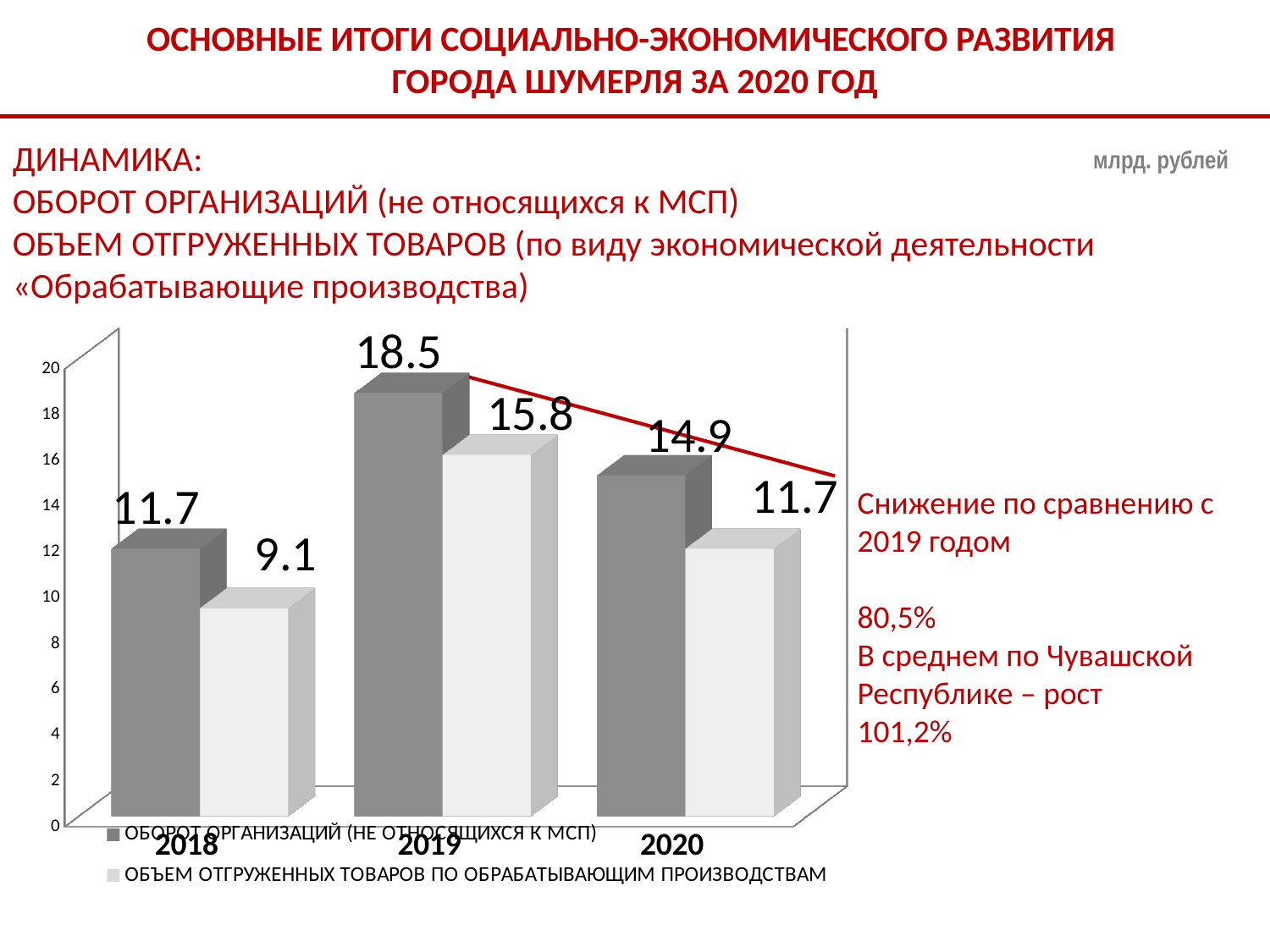
How many series does the legend list? 2 What kind of chart is shown on the slide? Bar chart What is the value of ОБОРОТ ОРГАНИЗАЦИЙ (НЕ ОТНОСЯЩИХСЯ К МСП) for 2019? 18.5 What is the value of ОБЪЕМ ОТГРУЖЕННЫХ ТОВАРОВ ПО ОБРАБАТЫВАЮЩИМ ПРОИЗВОДСТВАМ for 2018? 9.1 In which year is ОБЪЕМ ОТГРУЖЕННЫХ ТОВАРОВ ПО ОБРАБАТЫВАЮЩИМ ПРОИЗВОДСТВАМ lowest? 2018 In which year is ОБОРОТ ОРГАНИЗАЦИЙ (НЕ ОТНОСЯЩИХСЯ К МСП) highest? 2019 What is the difference between the two series in 2018? 2.6 How many years are shown on the x axis of the chart? 3 What is the value of ОБЪЕМ ОТГРУЖЕННЫХ ТОВАРОВ ПО ОБРАБАТЫВАЮЩИМ ПРОИЗВОДСТВАМ for 2020? 11.7 What unit is indicated for the chart values in the top right of the slide? млрд. рублей What is the difference between ОБОРОТ ОРГАНИЗАЦИЙ (НЕ ОТНОСЯЩИХСЯ К МСП) in 2019 and in 2020? 3.6 Which is larger: ОБОРОТ ОРГАНИЗАЦИЙ (НЕ ОТНОСЯЩИХСЯ К МСП) in 2020 or ОБЪЕМ ОТГРУЖЕННЫХ ТОВАРОВ ПО ОБРАБАТЫВАЮЩИМ ПРОИЗВОДСТВАМ in 2019? ОБЪЕМ ОТГРУЖЕННЫХ ТОВАРОВ ПО ОБРАБАТЫВАЮЩИМ ПРОИЗВОДСТВАМ in 2019